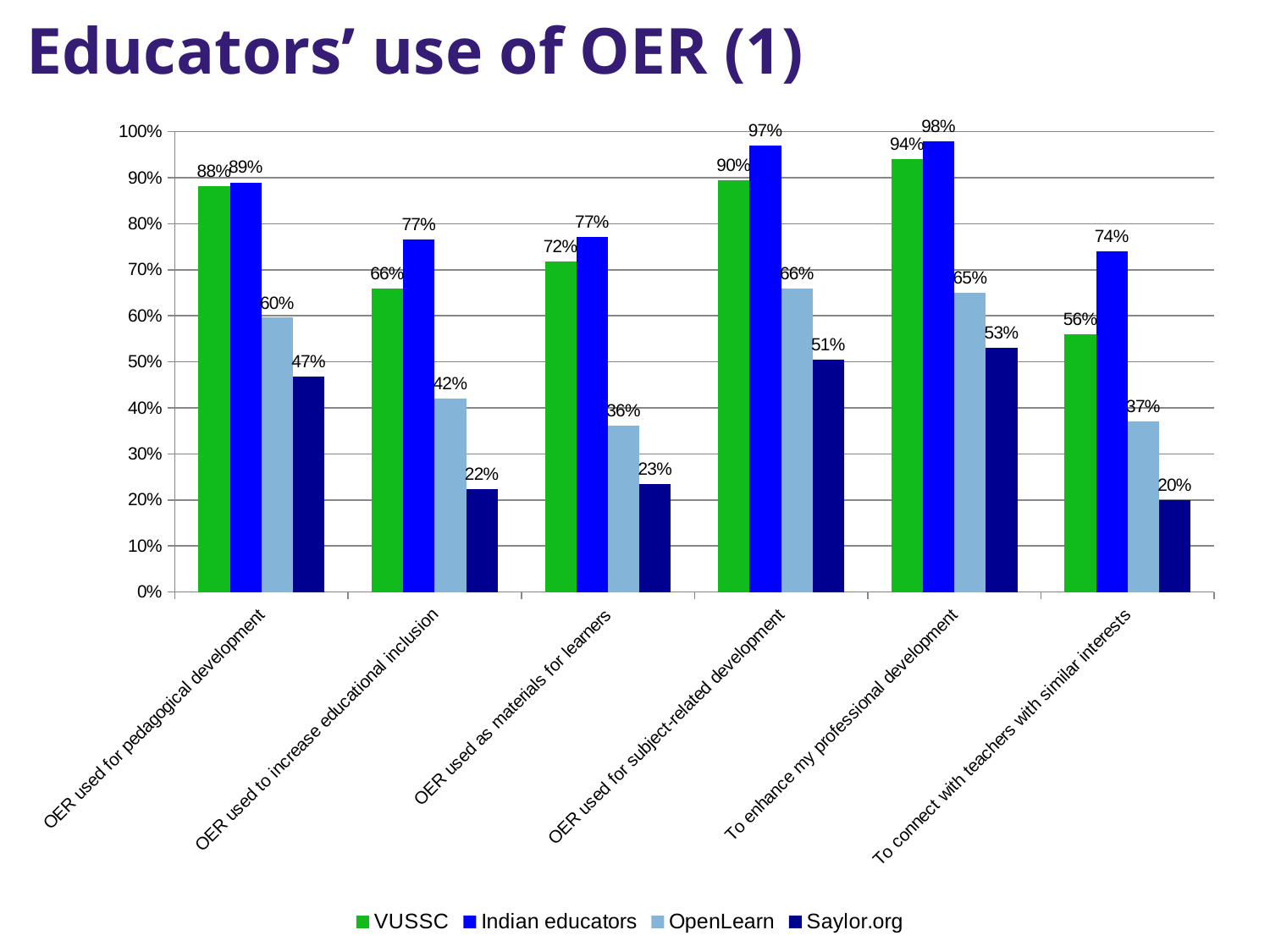
What is the difference between the Indian educators and VUSSC values for 'OER used to increase educational inclusion'? 11% How many categories are shown on the x axis? 6 How many series does the legend list? 4 Which category has the lowest value for Saylor.org? To connect with teachers with similar interests Which category has the highest value for Indian educators? To enhance my professional development Which is larger for 'OER used as materials for learners': the OpenLearn value or the Saylor.org value? OpenLearn Which series is shown in green in the legend? VUSSC What is the value for VUSSC for 'To enhance my professional development'? 94% What kind of chart is shown on the slide? Bar chart What is the value for Saylor.org for 'OER used to increase educational inclusion'? 22% What is the value for OpenLearn for 'To connect with teachers with similar interests'? 37% What is the value for Indian educators for 'OER used for subject-related development'? 97%